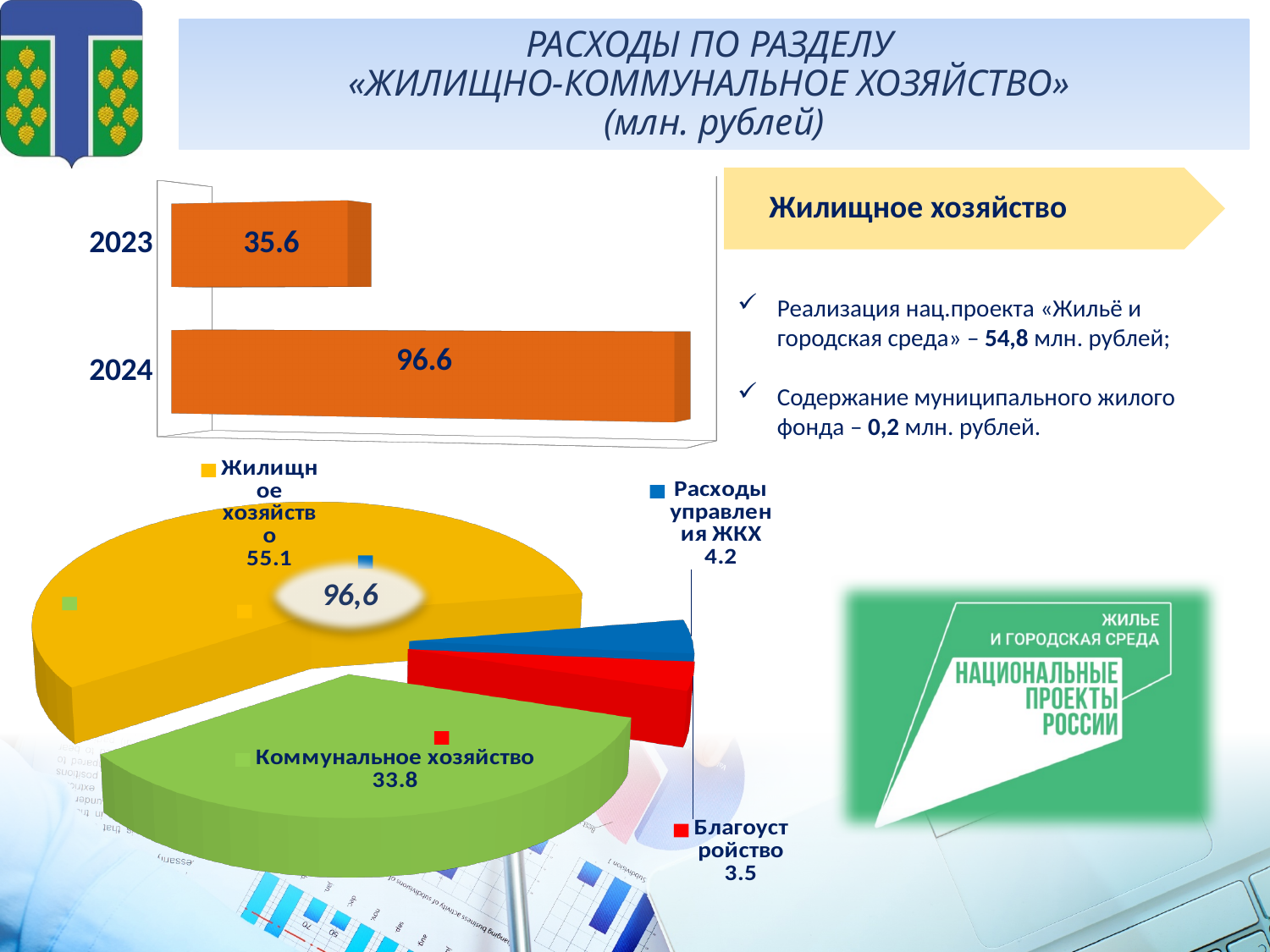
In the bar chart at the top left, how many bars are plotted? 2 In the pie chart at the bottom, what is the difference between Жилищное хозяйство and Коммунальное хозяйство? 21.3 In the pie chart at the bottom, which category has the smallest value? Благоустройство In the bar chart at the top left, which year has the larger value, 2023 or 2024? 2024 In the pie chart at the bottom, which category has the largest value? Жилищное хозяйство In the pie chart at the bottom, how many slices are there? 4 In the bar chart at the top left, what is the value for 2024? 96.6 What kind of chart is shown at the top left of the slide? Bar chart In the pie chart at the bottom, what is the value for Коммунальное хозяйство? 33.8 In the bar chart at the top left, what is the value for 2023? 35.6 In the bar chart at the top left, by how much does the 2024 value exceed the 2023 value? 61.0 In the pie chart at the bottom, what is the value for Расходы управления ЖКХ? 4.2